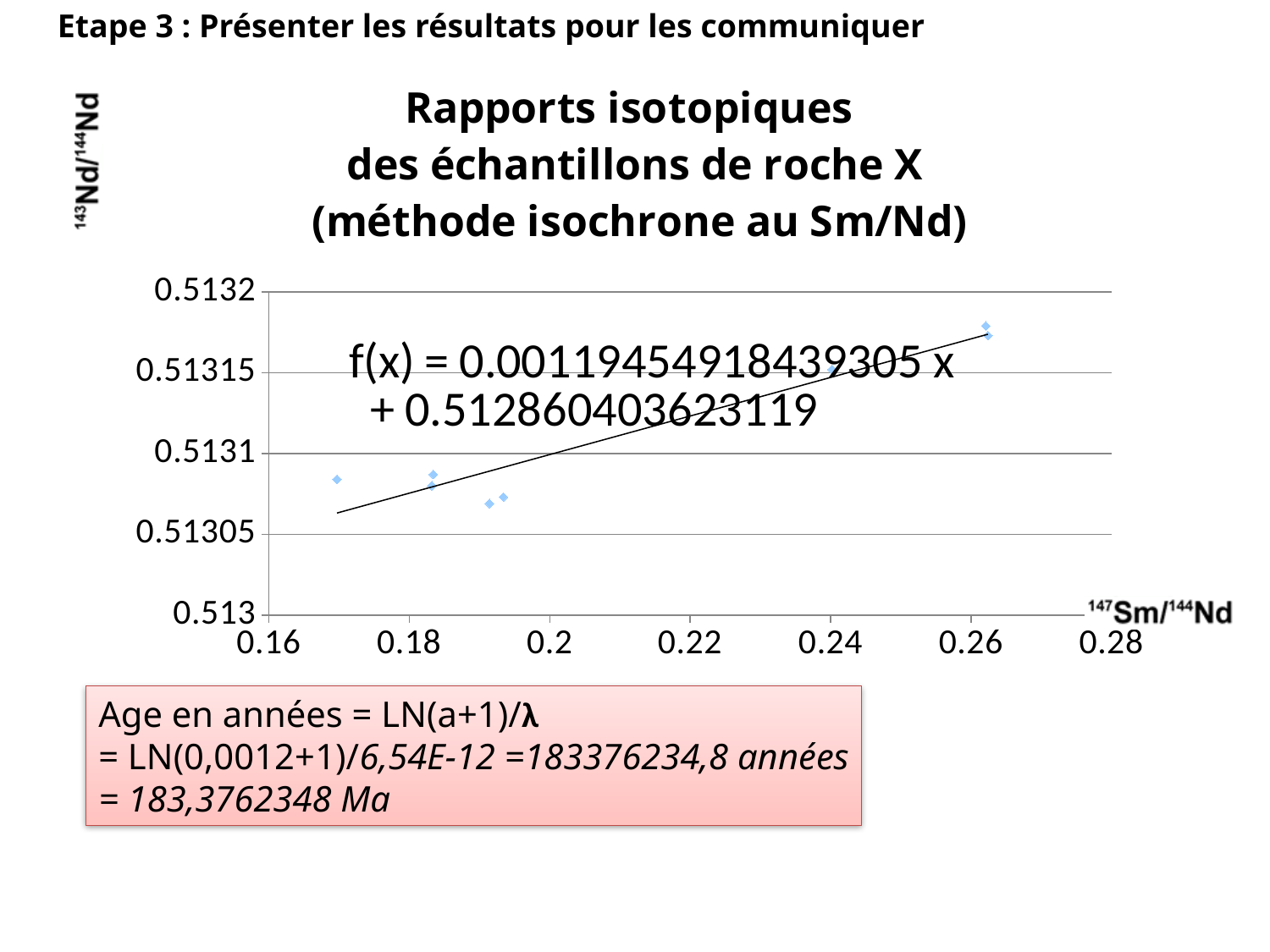
What is the highest value shown on the y axis of the chart? 0.5132 What is the intercept of the trendline equation printed on the chart? 0.512860403623119 What is the label of the x axis of the chart? 147Sm/144Nd What kind of chart is shown on the slide? Scatter chart with a trendline Which has the larger 143Nd/144Nd value: the point near 147Sm/144Nd = 0.17 or the points near 147Sm/144Nd = 0.26? The points near 0.26 What is the slope of the trendline equation printed on the chart? 0.00119454918439305 Is the 143Nd/144Nd value of the highest point near 147Sm/144Nd = 0.26 greater or less than 0.51315? greater Do the 143Nd/144Nd values rise or fall as 147Sm/144Nd increases along the x axis? Rise What is the title of the chart? Rapports isotopiques des échantillons de roche X (méthode isochrone au Sm/Nd) Is the 143Nd/144Nd value of the point near 147Sm/144Nd = 0.17 greater or less than 0.5131? less Are the 143Nd/144Nd values of the points near 147Sm/144Nd = 0.19 greater or less than 0.5131? less